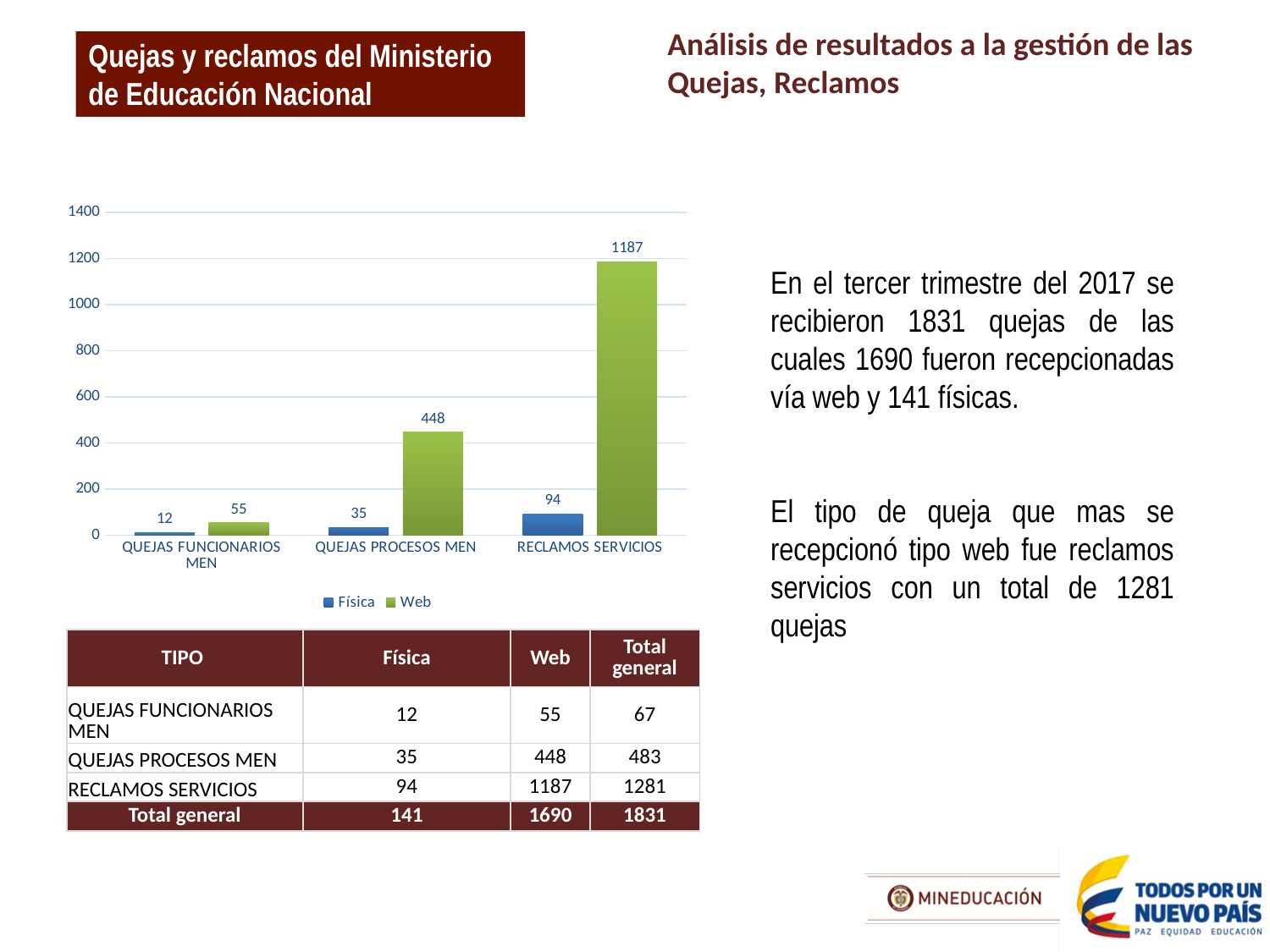
Which colour represents the Web series in the chart? green What kind of chart is shown on the slide? bar chart Which is larger: the Física value for RECLAMOS SERVICIOS or the Web value for QUEJAS FUNCIONARIOS MEN? Física value for RECLAMOS SERVICIOS Is the Web value for QUEJAS PROCESOS MEN greater or less than 400? greater How many series does the chart legend list? 2 What is the Web value for QUEJAS FUNCIONARIOS MEN? 55 Which category has the highest Web value? RECLAMOS SERVICIOS Which category has the lowest Física value? QUEJAS FUNCIONARIOS MEN How many categories are shown on the x axis of the chart? 3 What is the Física value for QUEJAS PROCESOS MEN? 35 What is the Web value for RECLAMOS SERVICIOS? 1187 What is the difference between the Web and Física values for QUEJAS PROCESOS MEN? 413